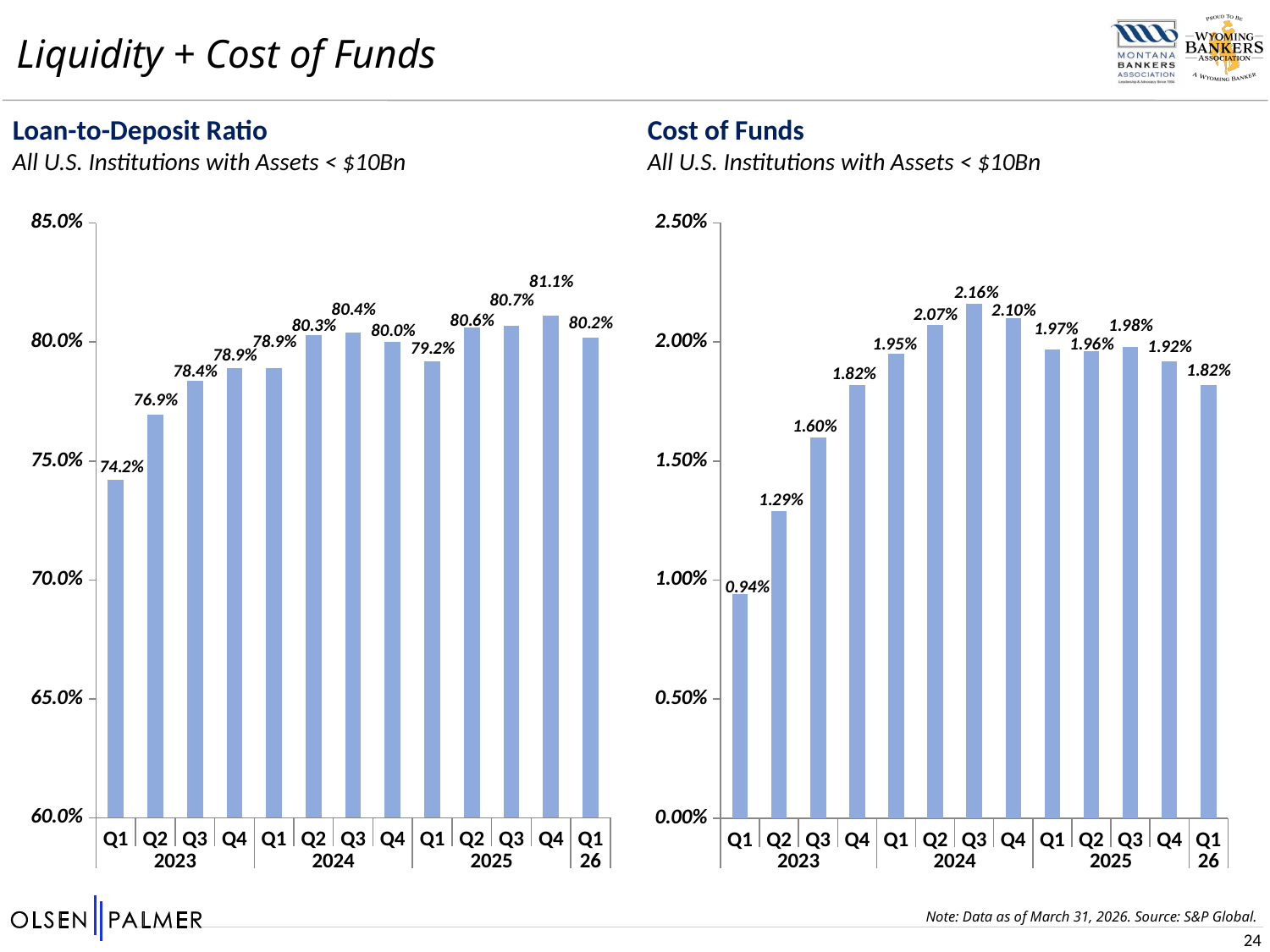
In the Loan-to-Deposit Ratio chart, what is the value for Q1 2023? 74.2% In the Cost of Funds chart, is the value for Q2 2023 greater or less than 1.50%? less In the Cost of Funds chart, which is larger, the value for Q1 2025 or Q3 2025? Q3 2025 In the Cost of Funds chart, what is the difference between Q3 2024 and Q1 26? 0.34% In the Loan-to-Deposit Ratio chart, what is the difference between Q4 2025 and Q1 2023? 6.9% In the Loan-to-Deposit Ratio chart, which quarter has the highest value? Q4 2025 In the Cost of Funds chart, which quarter has the lowest value? Q1 2023 In the Cost of Funds chart, what is the value for Q3 2024? 2.16% What kind of chart is the Cost of Funds chart? bar chart In the Cost of Funds chart, do values rise or fall from Q1 2023 to Q3 2024? rise What is the subtitle shown under the Loan-to-Deposit Ratio chart title? All U.S. Institutions with Assets < $10Bn In the Loan-to-Deposit Ratio chart, how many quarters are plotted? 13